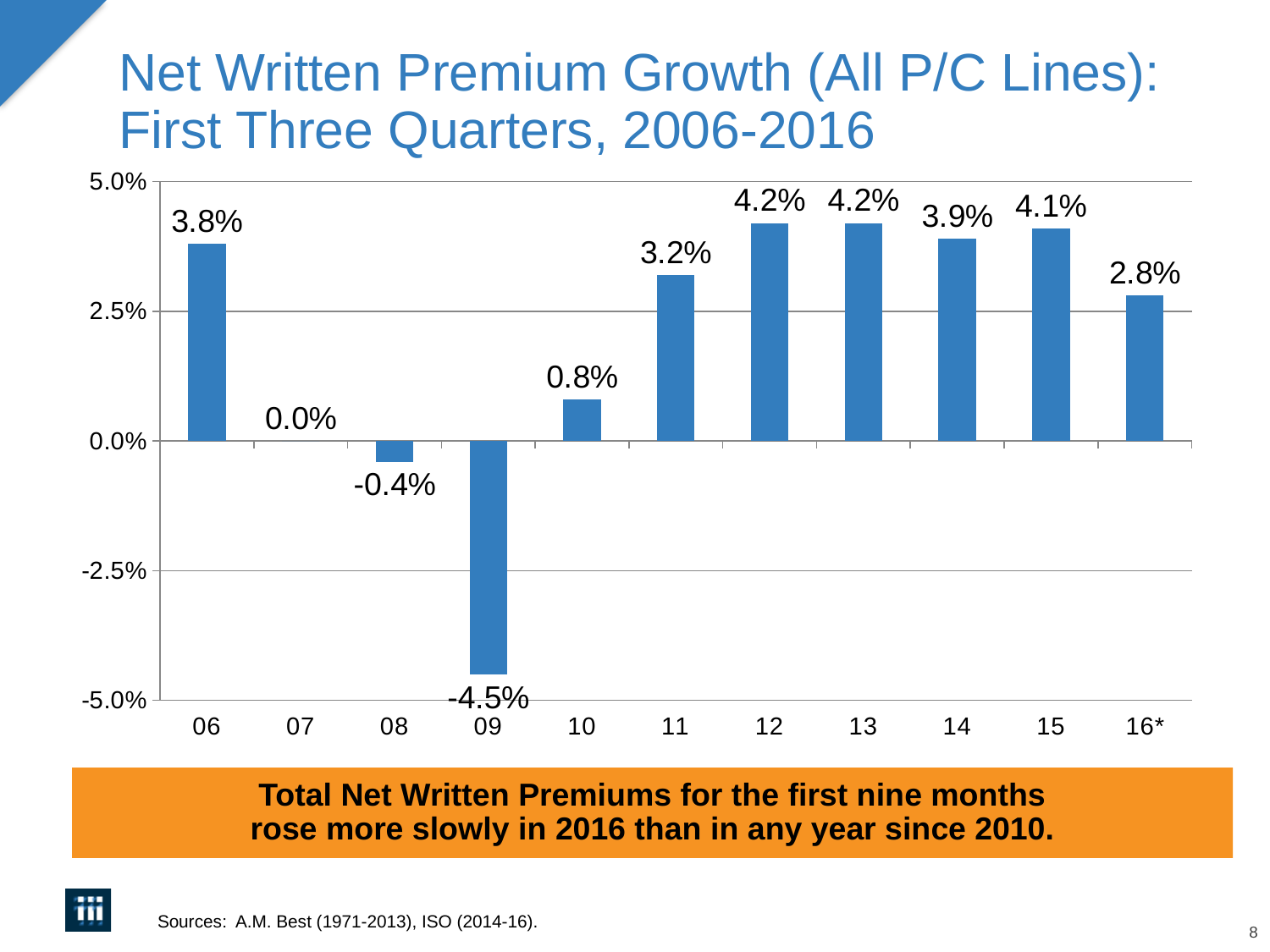
Which is larger, the value for 11 or the value for 14? 14 Which years share the highest value of 4.2%? 12 and 13 What is the difference between the values for 15 and 16*? 1.3% Which year has the lowest net written premium growth? 09 What is the value shown for 16*? 2.8% How many years (categories) are shown on the x axis? 11 What is the title of the chart? Net Written Premium Growth (All P/C Lines): First Three Quarters, 2006-2016 What is the difference between the values for 06 and 09? 8.3% Do the values rise or fall from 09 to 12? Rise What is the net written premium growth value for 2009 (09)? -4.5% What is the value shown for 2010 (10)? 0.8% What kind of chart is shown on the slide? Bar chart